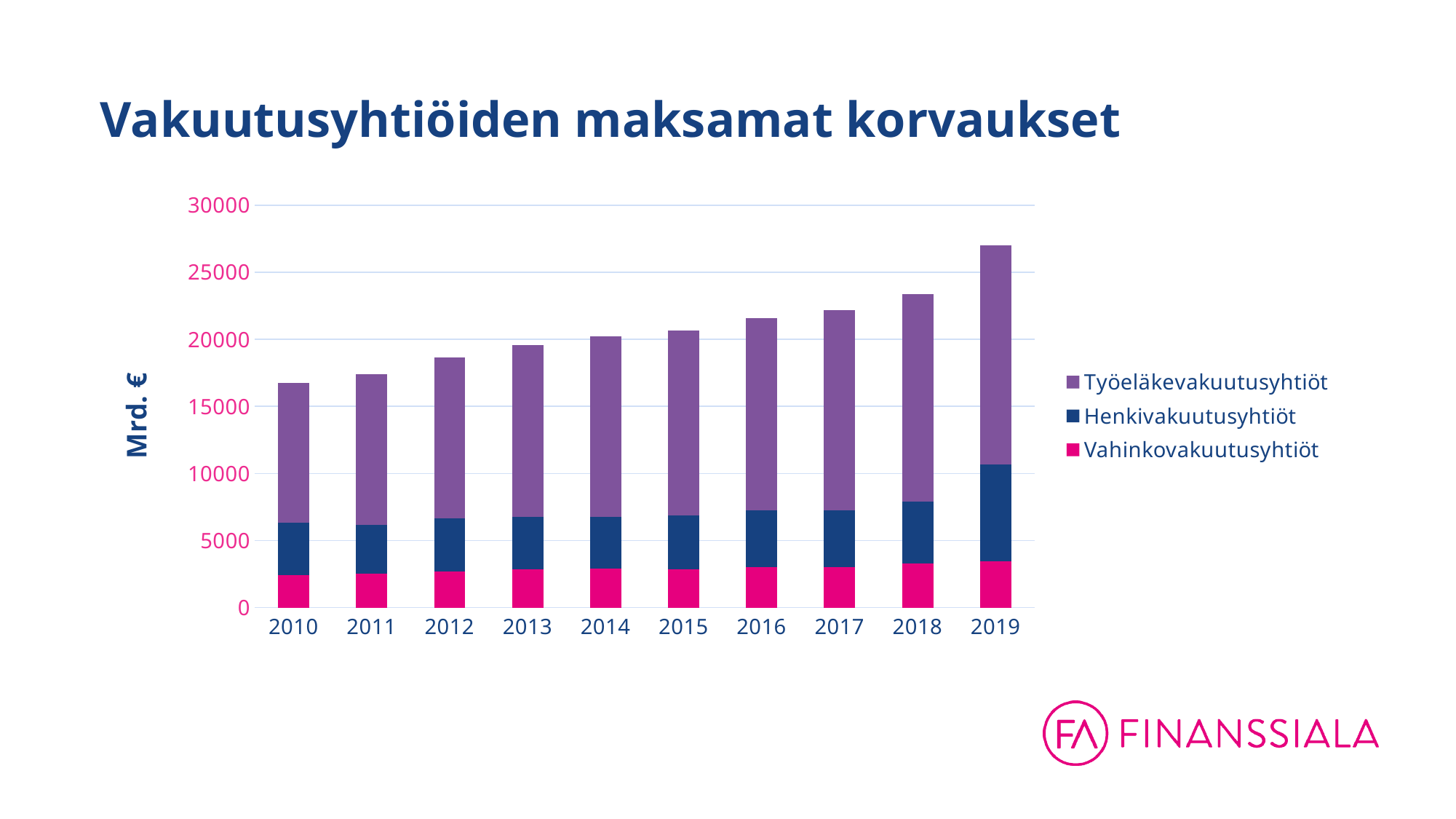
Is the total bar for 2019 greater or less than 25000? greater How many years are shown on the x axis of the chart? 10 Is the Vahinkovakuutusyhtiöt segment for 2019 greater or less than 5000? less Do the total bar heights rise or fall from 2010 to 2019? Rise Which year has the lowest total bar? 2010 What kind of chart is shown on the slide? Stacked bar chart How many series does the legend list? 3 Is the total bar for 2010 greater or less than 20000? less What is the label on the vertical axis? Mrd. € What is the title of the chart? Vakuutusyhtiöiden maksamat korvaukset Which year has the larger Henkivakuutusyhtiöt segment, 2018 or 2019? 2019 Which year has the highest total bar? 2019